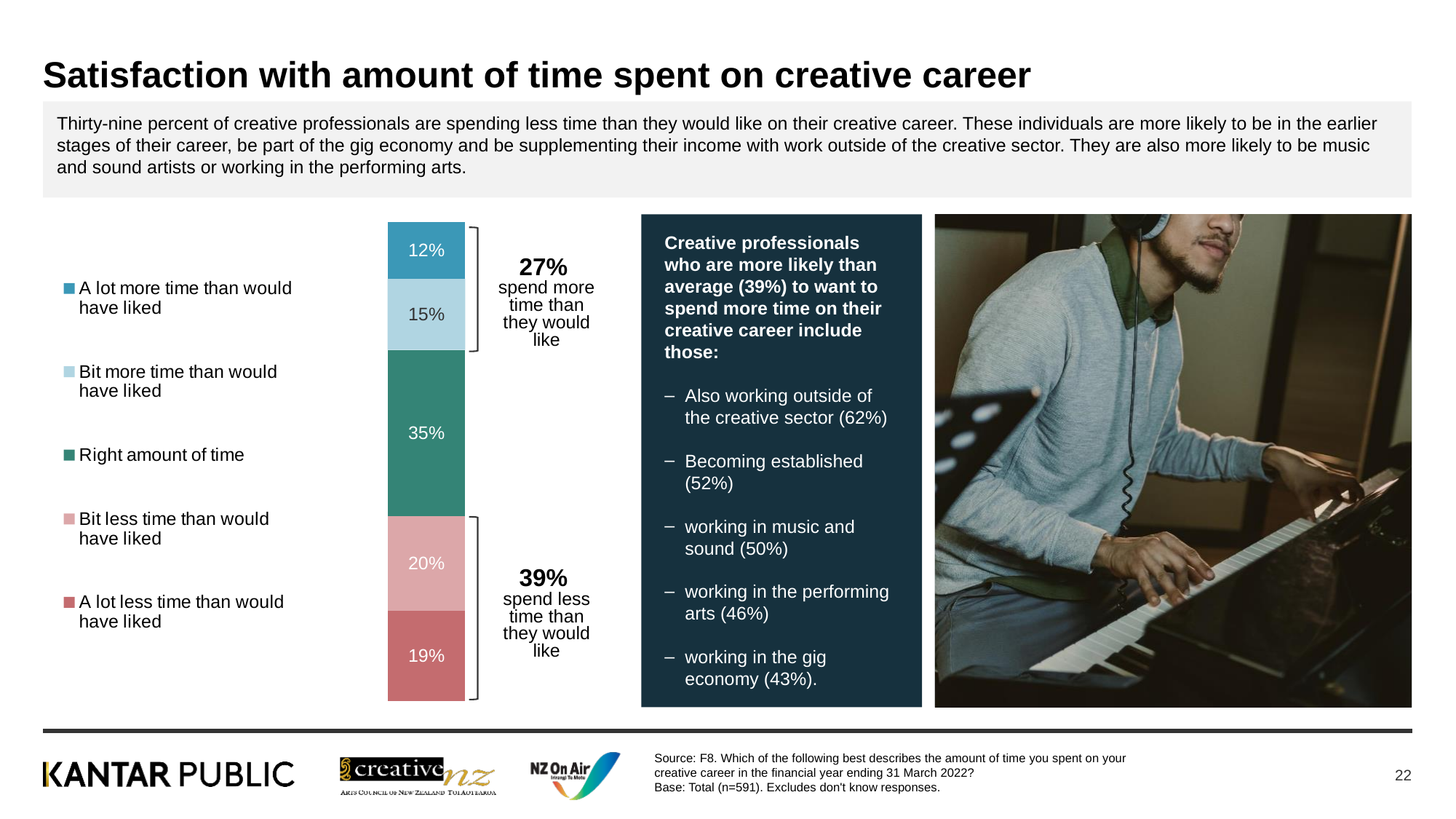
How many entries does the legend list? 5 Which is larger: the share for 'Bit more time than would have liked' or 'Bit less time than would have liked'? Bit less time than would have liked Which response category has the largest share in the stacked bar? Right amount of time Which response category has the smallest share in the stacked bar? A lot more time than would have liked How many segments make up the stacked bar? 5 What kind of chart is shown on the slide? Stacked bar chart What is the difference between the share for 'Bit less time than would have liked' and 'A lot less time than would have liked'? 1% What combined percentage is shown for those who spend less time than they would like? 39% What percentage said they spent a lot less time than they would have liked? 19% What percentage said they spent a lot more time than they would have liked? 12% What percentage said they spent a bit more time than they would have liked? 15% What percentage of creative professionals said they spent the right amount of time on their creative career? 35%